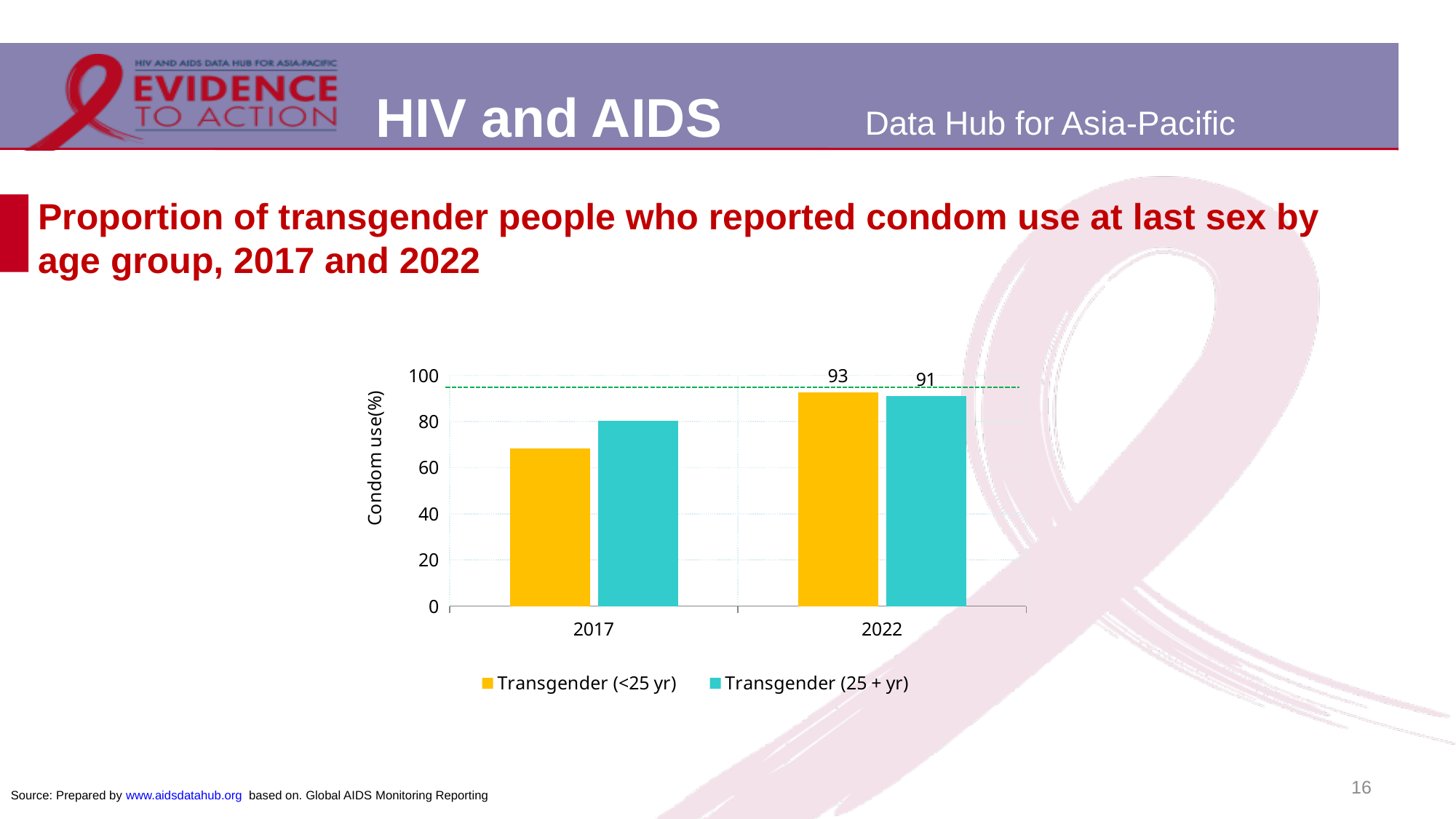
How many years are shown on the x axis? 2 In which year is the Transgender (25 + yr) value highest? 2022 What kind of chart is shown on the slide? bar chart Is the value for Transgender (25 + yr) in 2017 greater or less than 60? greater What is the difference between the Transgender (<25 yr) and Transgender (25 + yr) values in 2022? 2 What is the value for Transgender (25 + yr) in 2022? 91 How many series does the legend list? 2 Does the value for Transgender (<25 yr) rise or fall from 2017 to 2022? rise What is the label on the vertical axis of the chart? Condom use(%) In 2022, which series has the larger value, Transgender (<25 yr) or Transgender (25 + yr)? Transgender (<25 yr) What is the value for Transgender (<25 yr) in 2022? 93 Is the value for Transgender (<25 yr) in 2017 greater or less than 80? less